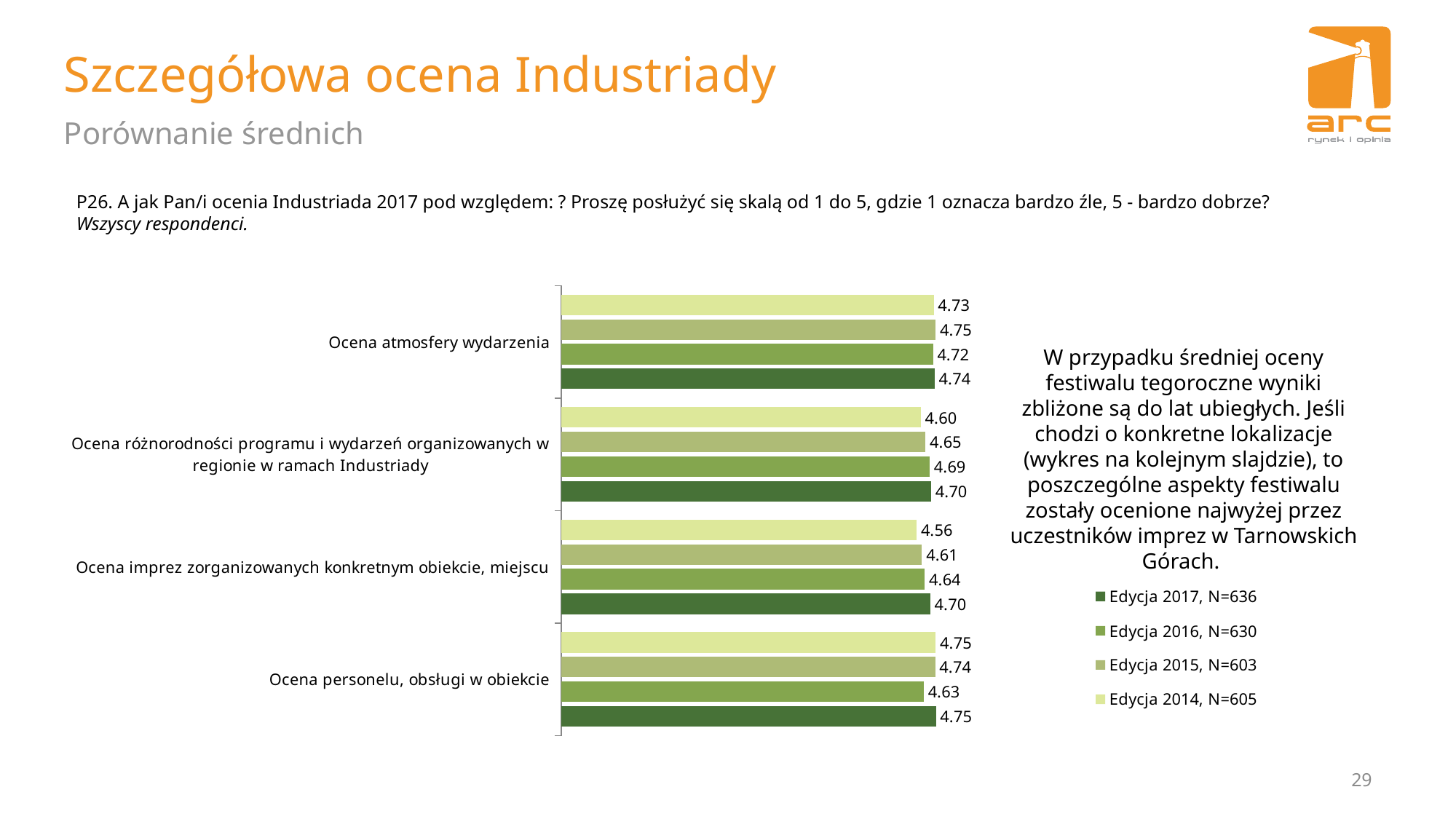
What kind of chart is shown on the slide? Bar chart How many series does the legend list? 4 What is the value for Edycja 2015 for "Ocena różnorodności programu i wydarzeń organizowanych w regionie w ramach Industriady"? 4.65 What is the value for Edycja 2014 for "Ocena imprez zorganizowanych konkretnym obiekcie, miejscu"? 4.56 How many categories are shown on the chart? 4 What is the value for Edycja 2017 for "Ocena atmosfery wydarzenia"? 4.74 What is the value for Edycja 2016 for "Ocena personelu, obsługi w obiekcie"? 4.63 What sample size (N) does the legend give for Edycja 2015? N=603 Which category has the lowest value for Edycja 2014? Ocena imprez zorganizowanych konkretnym obiekcie, miejscu Which category has the lowest value for Edycja 2016? Ocena personelu, obsługi w obiekcie Which is larger for "Ocena personelu, obsługi w obiekcie": the Edycja 2016 value or the Edycja 2015 value? Edycja 2015 What is the difference between the Edycja 2017 and Edycja 2014 values for "Ocena imprez zorganizowanych konkretnym obiekcie, miejscu"? 0.14